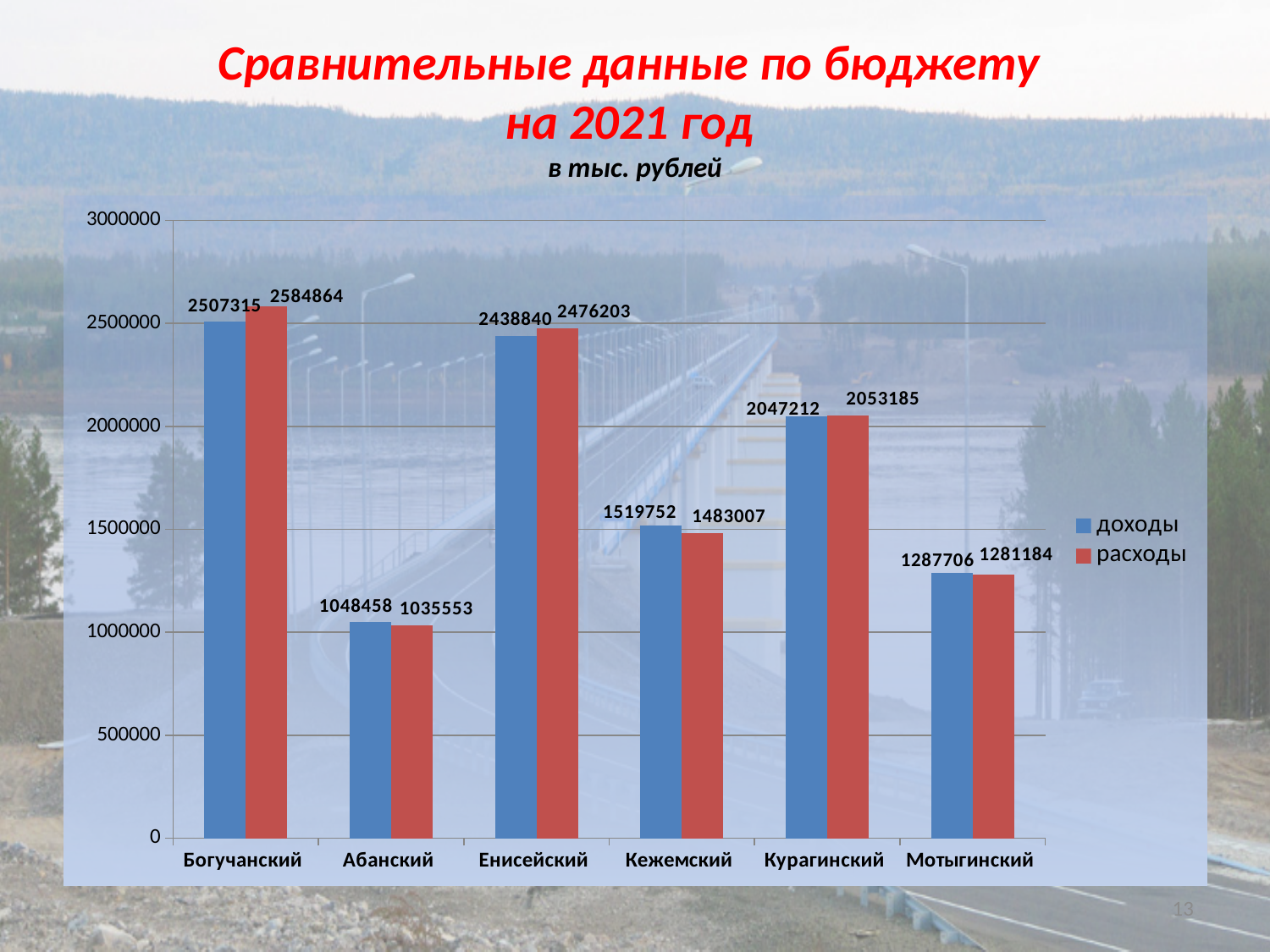
How many categories are shown on the x axis? 6 What kind of chart is shown on the slide? bar chart Which is larger for Кежемский: доходы or расходы? доходы What is the difference between доходы and расходы for Кежемский? 36745 Is the value of доходы for Абанский greater or less than 1500000? less Which category has the lowest расходы? Абанский What is the value of расходы for Енисейский? 2476203 Which category has the highest доходы? Богучанский What is the difference between расходы and доходы for Богучанский? 77549 What is the value of доходы for Богучанский? 2507315 What is the value of расходы for Мотыгинский? 1281184 How many series does the legend list? 2